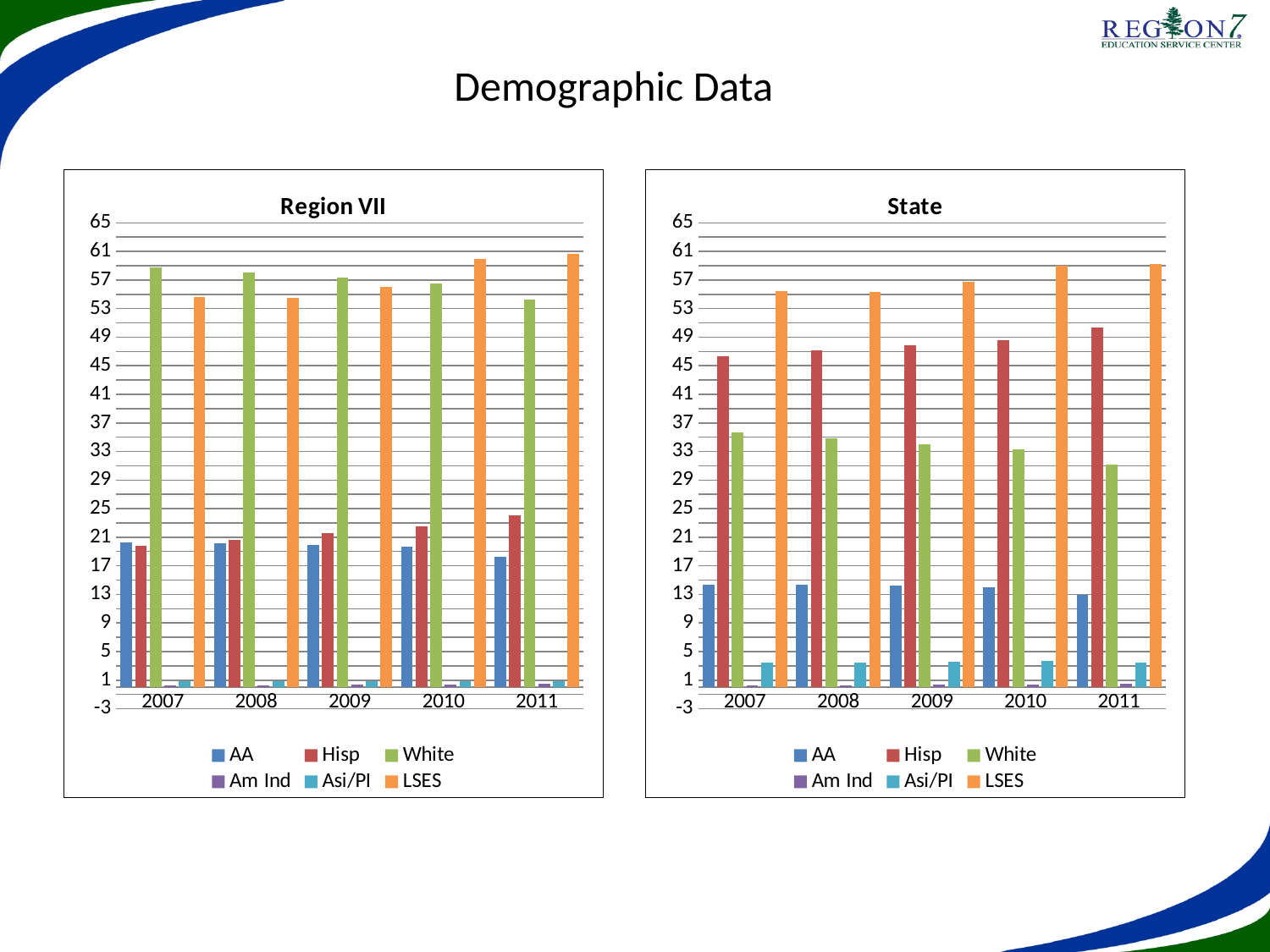
In the Region VII chart, is the value for White in 2007 greater or less than 53? greater In the State chart, is the value for White in 2011 greater or less than 33? less How many series does the legend of the Region VII chart list? 6 In the State chart, which series has the lowest value in 2007? Am Ind In the Region VII chart, which series has the highest value in 2011? LSES In the State chart, do the values for White rise or fall from 2007 to 2011? fall In the State chart, which is larger in 2011, Hisp or White? Hisp How many years are shown on the x axis of the State chart? 5 In the Region VII chart, which is larger in 2007, White or LSES? White In the State chart, is the value for AA in 2007 greater or less than 17? less What kind of chart is the Region VII chart? bar chart What is the title of the chart on the right side of the slide? State